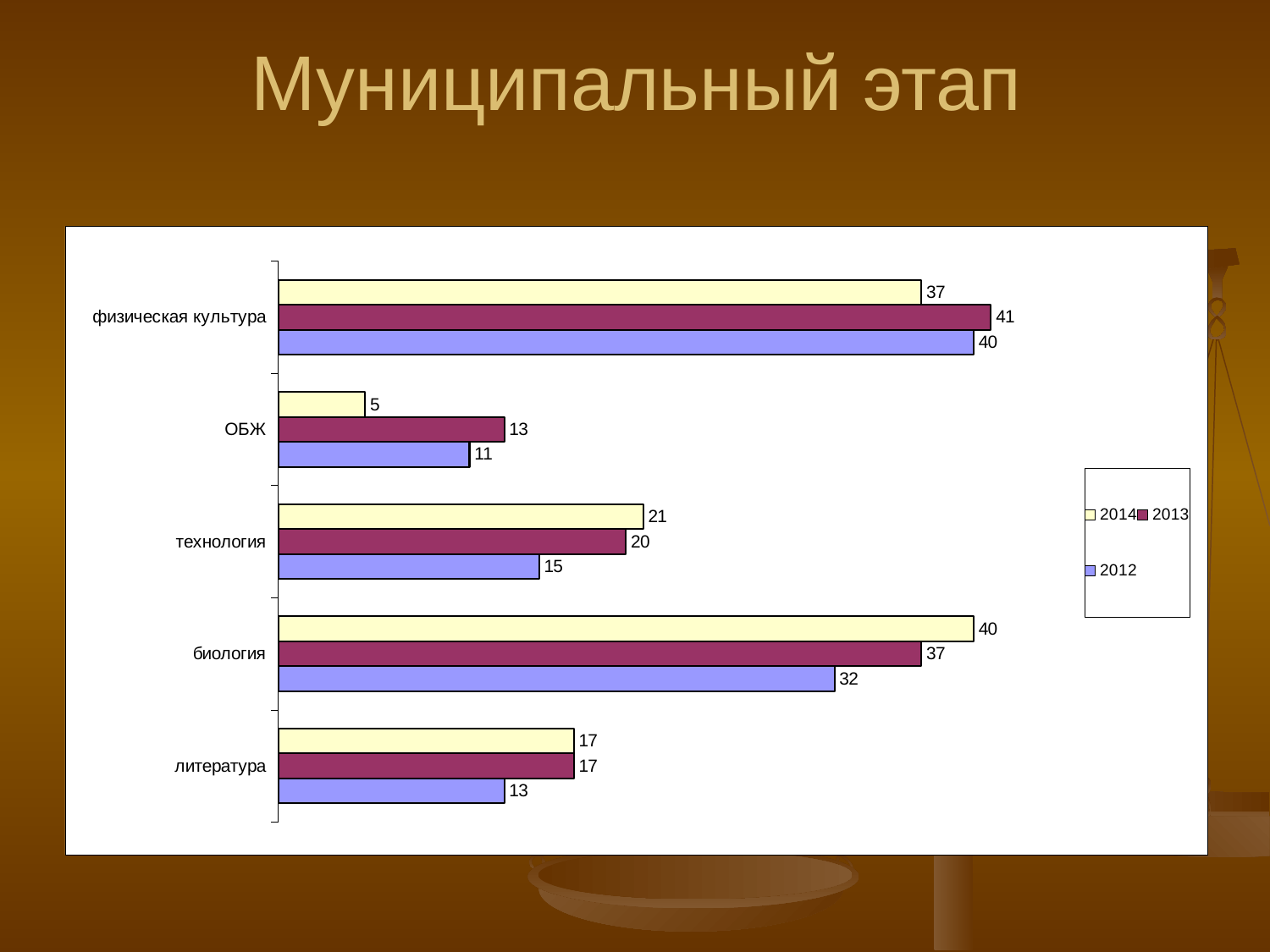
What is the value for биология in 2012? 32 What is the difference between the 2013 and 2014 values for ОБЖ? 8 What kind of chart is shown on the slide? bar chart What is the value for ОБЖ in 2014? 5 Which is larger for биология: the 2013 value or the 2012 value? 2013 Which category has the highest value in 2014? биология How many series does the legend list? 3 Which category has the lowest value in 2012? ОБЖ What is the difference between the 2014 and 2012 values for технология? 6 How many categories are shown on the chart? 5 What is the value for физическая культура in 2013? 41 What is the title of the slide? Муниципальный этап